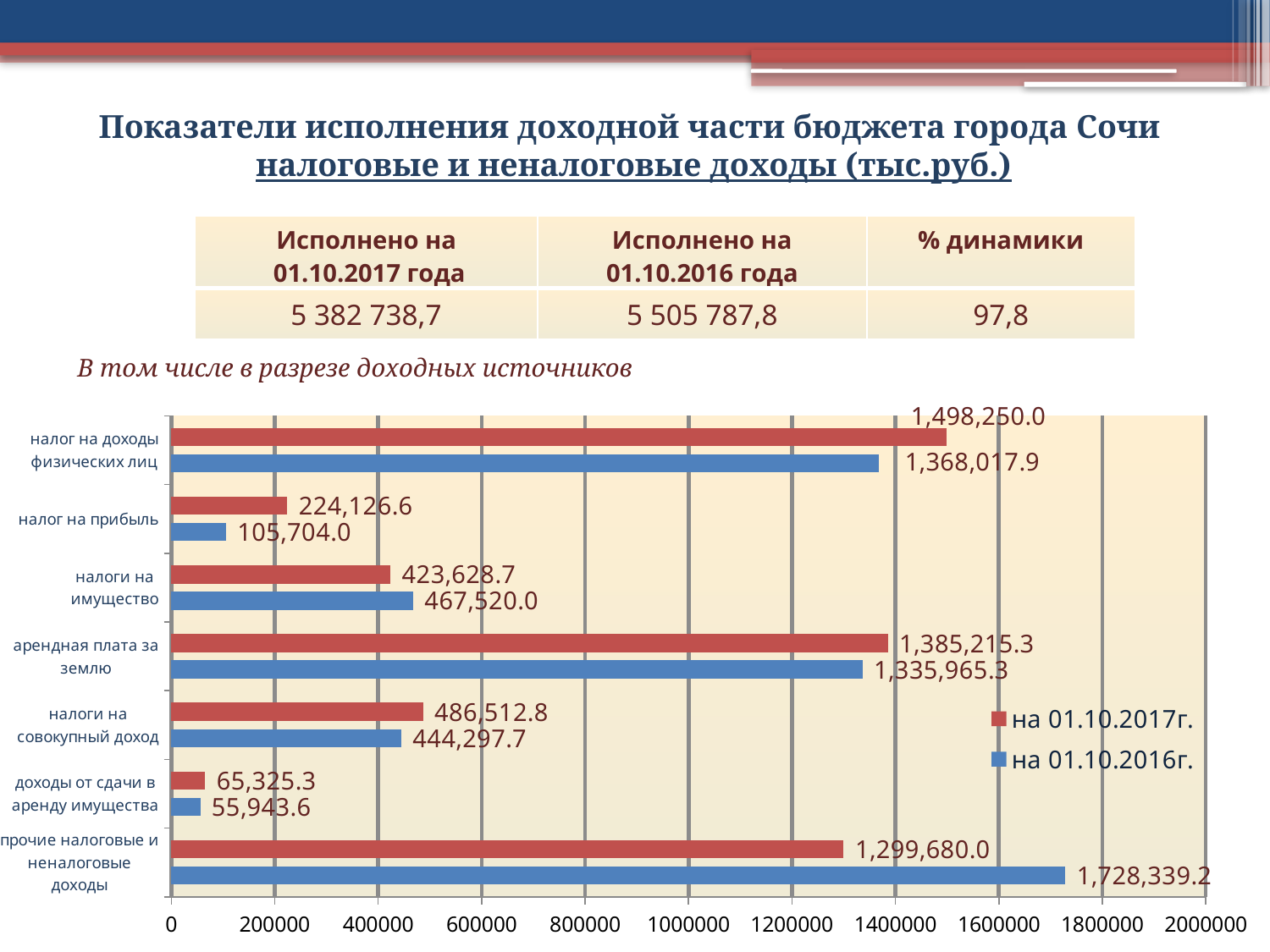
Which category has the lowest value in the series на 01.10.2016г.? доходы от сдачи в аренду имущества What kind of chart is shown on the slide? bar chart What is the value for прочие налоговые и неналоговые доходы in the series на 01.10.2016г.? 1,728,339.2 How many categories are shown on the chart? 7 What is the value for налог на доходы физических лиц in the series на 01.10.2017г.? 1,498,250.0 What is the difference between the 2017 and 2016 values for налог на прибыль? 118,422.6 How many series does the chart legend list? 2 What is the value for налоги на совокупный доход in the series на 01.10.2016г.? 444,297.7 Is the value for арендная плата за землю in the series на 01.10.2017г. greater or less than 1200000? greater For налоги на имущество, which series has the larger value: на 01.10.2017г. or на 01.10.2016г.? на 01.10.2016г. What is the difference between the 2016 and 2017 values for прочие налоговые и неналоговые доходы? 428,659.2 Which category has the highest value in the series на 01.10.2017г.? налог на доходы физических лиц